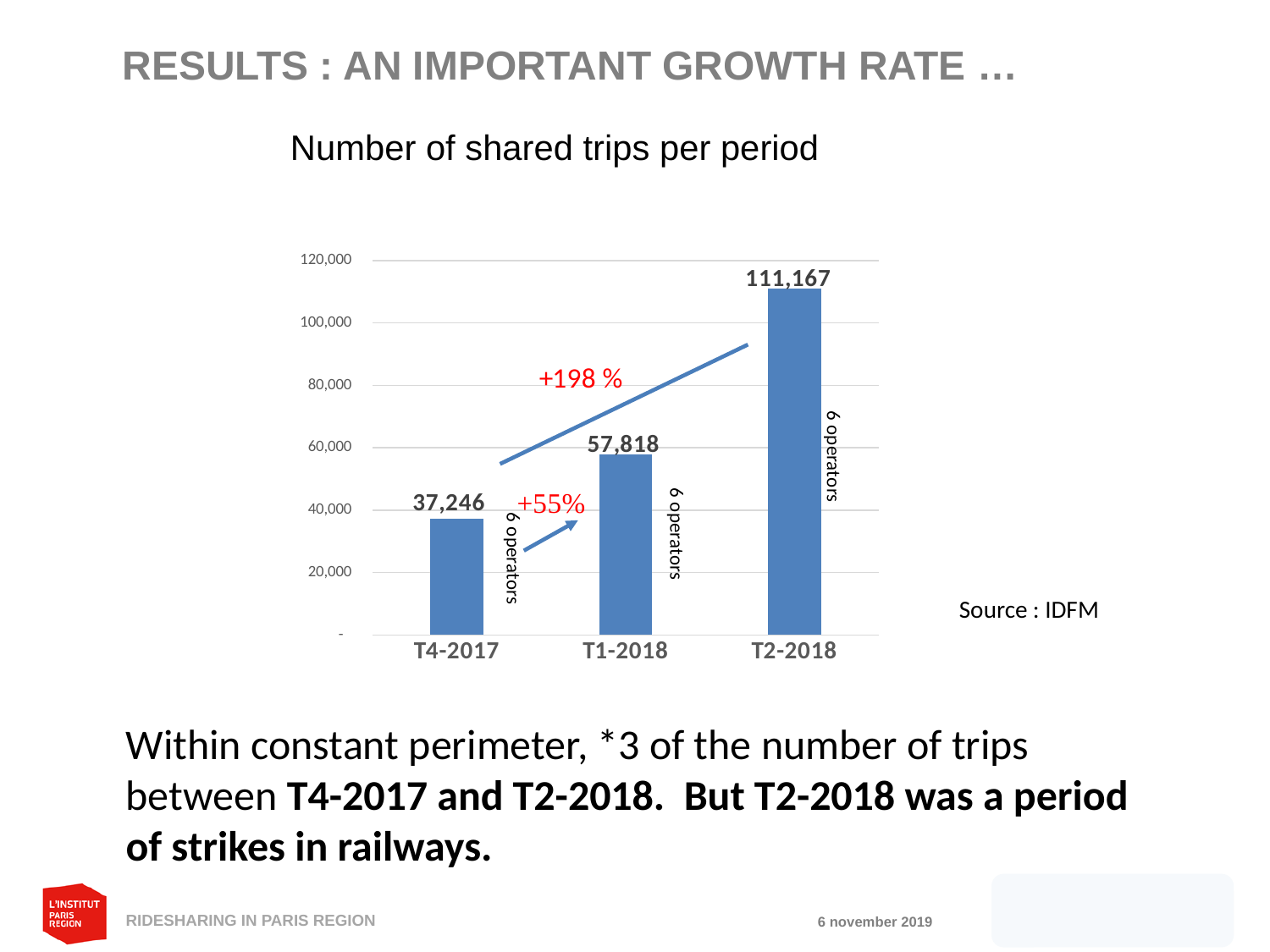
What is the number of shared trips for T4-2017? 37,246 What is the number of shared trips for T2-2018? 111,167 What kind of chart is shown on the slide? bar chart What is the number of shared trips for T1-2018? 57,818 Is the value for T2-2018 greater or less than 100,000? greater Which period has the highest number of shared trips? T2-2018 What is the difference in shared trips between T1-2018 and T4-2017? 20,572 Which period has more shared trips, T4-2017 or T1-2018? T1-2018 What is the difference in shared trips between T2-2018 and T1-2018? 53,349 Which period has the lowest number of shared trips? T4-2017 Do the values rise or fall from T4-2017 to T2-2018? rise How many periods are shown on the chart? 3